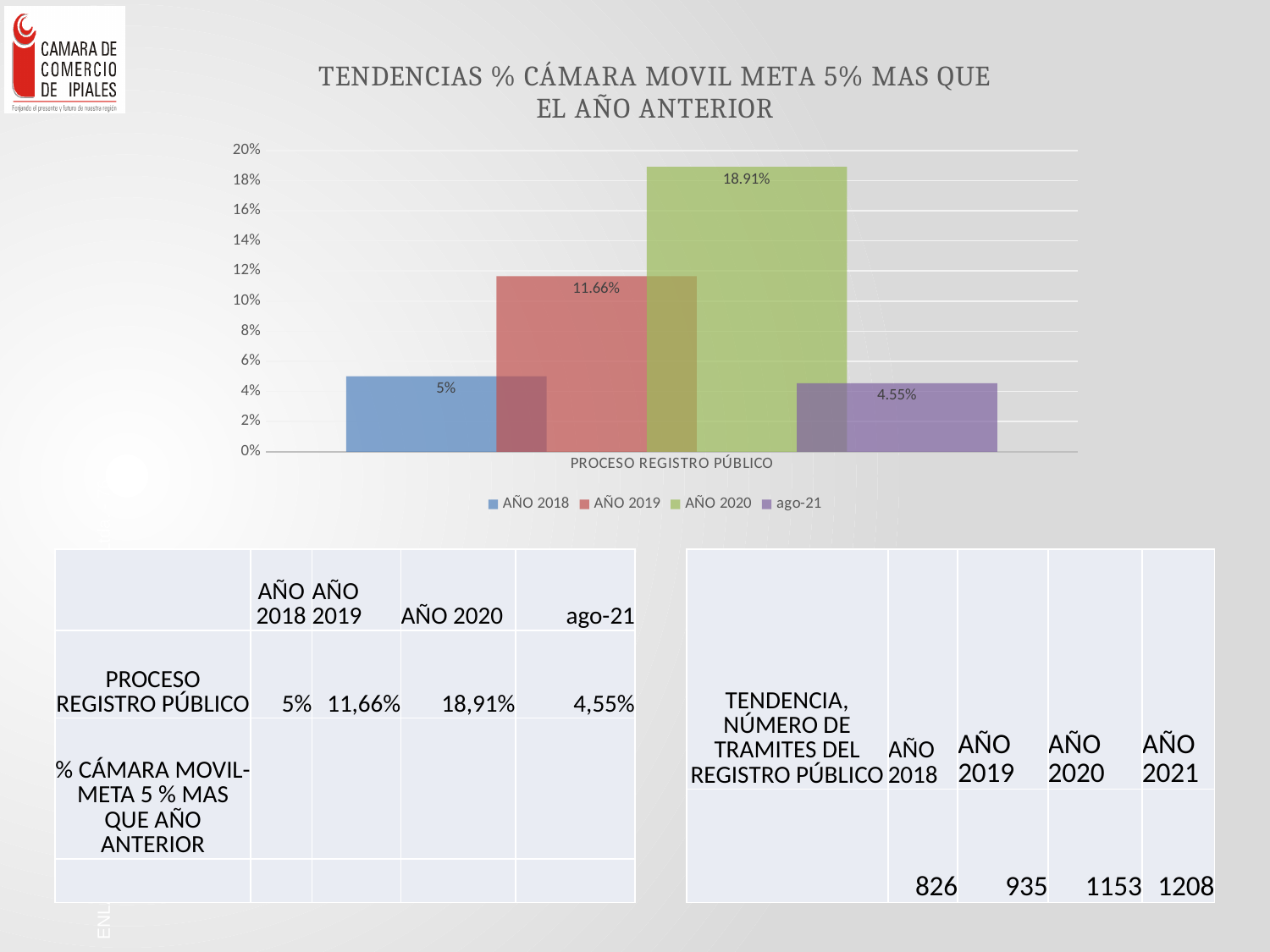
What kind of chart is shown on the slide? bar chart Which series has the lowest value in the chart? ago-21 How many series does the legend list? 4 What is the difference between the AÑO 2020 and AÑO 2019 values? 7.25% What is the value for AÑO 2019 in the chart? 11.66% What is the value for AÑO 2018 in the chart? 5% Which series has the highest value in the chart? AÑO 2020 What is the title of the chart? TENDENCIAS % CÁMARA MOVIL META 5% MAS QUE EL AÑO ANTERIOR What is the value for AÑO 2020 in the chart? 18.91% What is the value for ago-21 in the chart? 4.55% Which is larger, the value for AÑO 2019 or the value for AÑO 2018? AÑO 2019 What is the category label shown on the x axis of the chart? PROCESO REGISTRO PÚBLICO